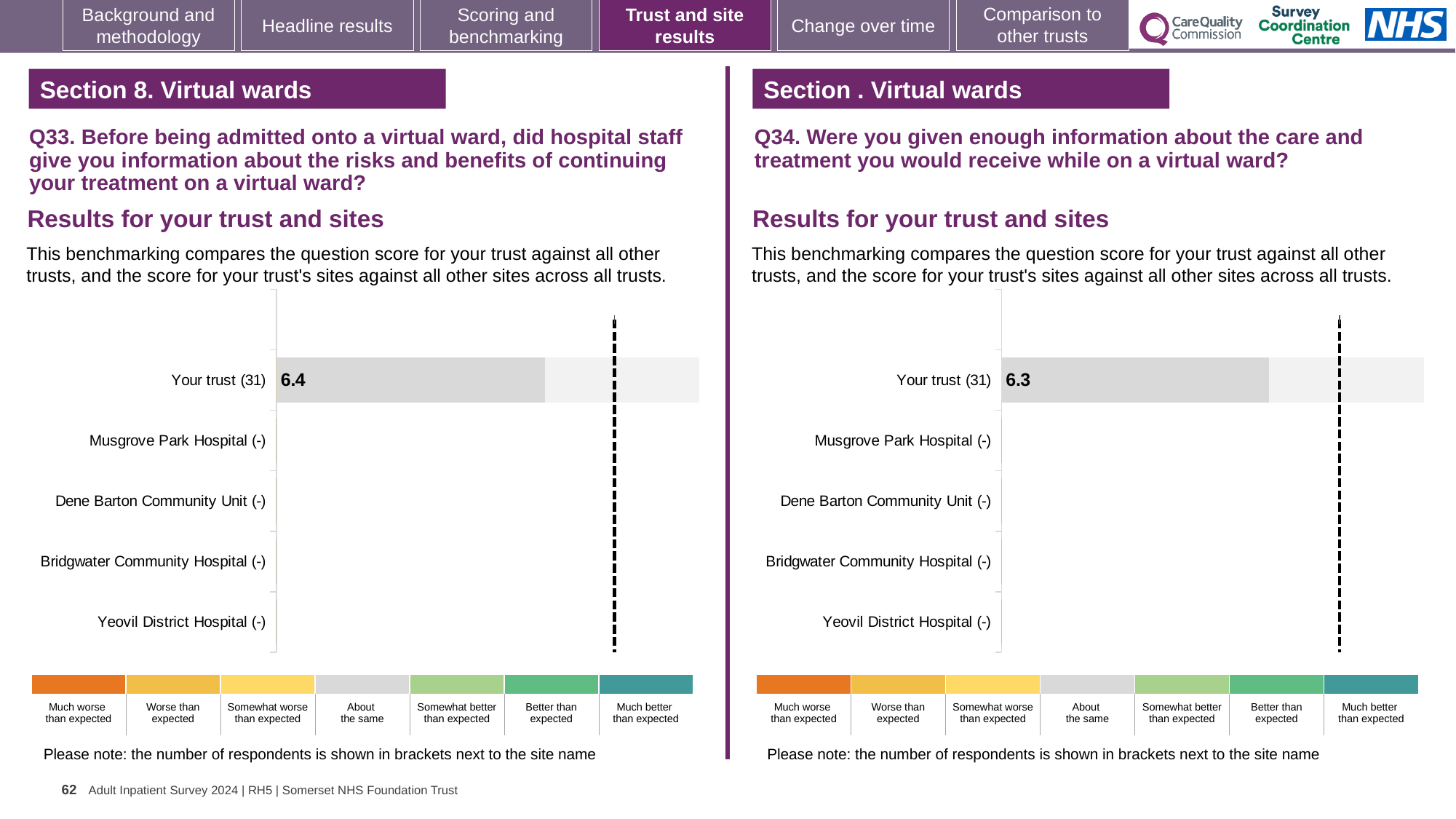
How many benchmark categories does the colour key below the left chart (Q33) list? 7 How many site/trust categories are listed on the y axis of the right chart (Q34)? 5 In the right chart (Q34), what is the score for Your trust? 6.3 Which is larger: the Your trust score in the left chart (Q33) or in the right chart (Q34)? Left chart (Q33), 6.4 How many site/trust categories are listed on the y axis of the left chart (Q33)? 5 What kind of chart is used in the left chart (Q33)? Bar chart In the left chart (Q33), how many respondents are shown in brackets next to Your trust? 31 In the right chart (Q34), which category has a plotted bar? Your trust (31) In the left chart (Q33), what is the score for Your trust? 6.4 What is the difference between the Your trust score in the left chart (Q33) and the right chart (Q34)? 0.1